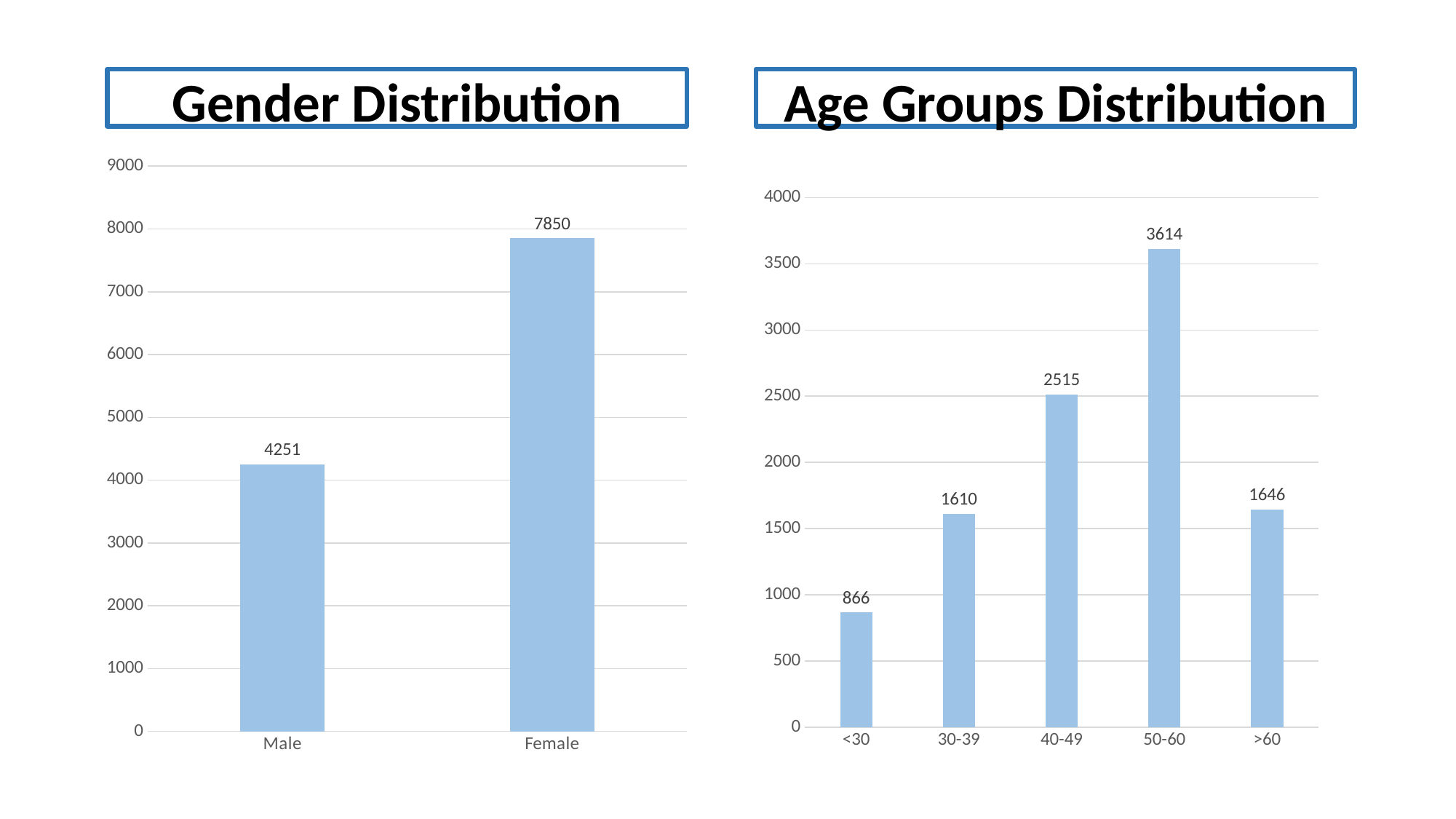
In the Age Groups Distribution chart, what is the value for the 40-49 group? 2515 In the Age Groups Distribution chart, what is the difference between the 50-60 and 40-49 values? 1099 In the Gender Distribution chart, what is the difference between the Female and Male values? 3599 In the Gender Distribution chart, what is the value for Male? 4251 In the Age Groups Distribution chart, which age group has the lowest value? <30 What kind of chart is the Age Groups Distribution chart? Bar chart In the Gender Distribution chart, what is the value for Female? 7850 In the Gender Distribution chart, how many categories are shown? 2 In the Age Groups Distribution chart, how many age groups are shown? 5 In the Age Groups Distribution chart, which age group has the highest value? 50-60 In the Age Groups Distribution chart, is the value for <30 greater or less than 1000? less In the Age Groups Distribution chart, which is larger, the value for 30-39 or the value for >60? >60